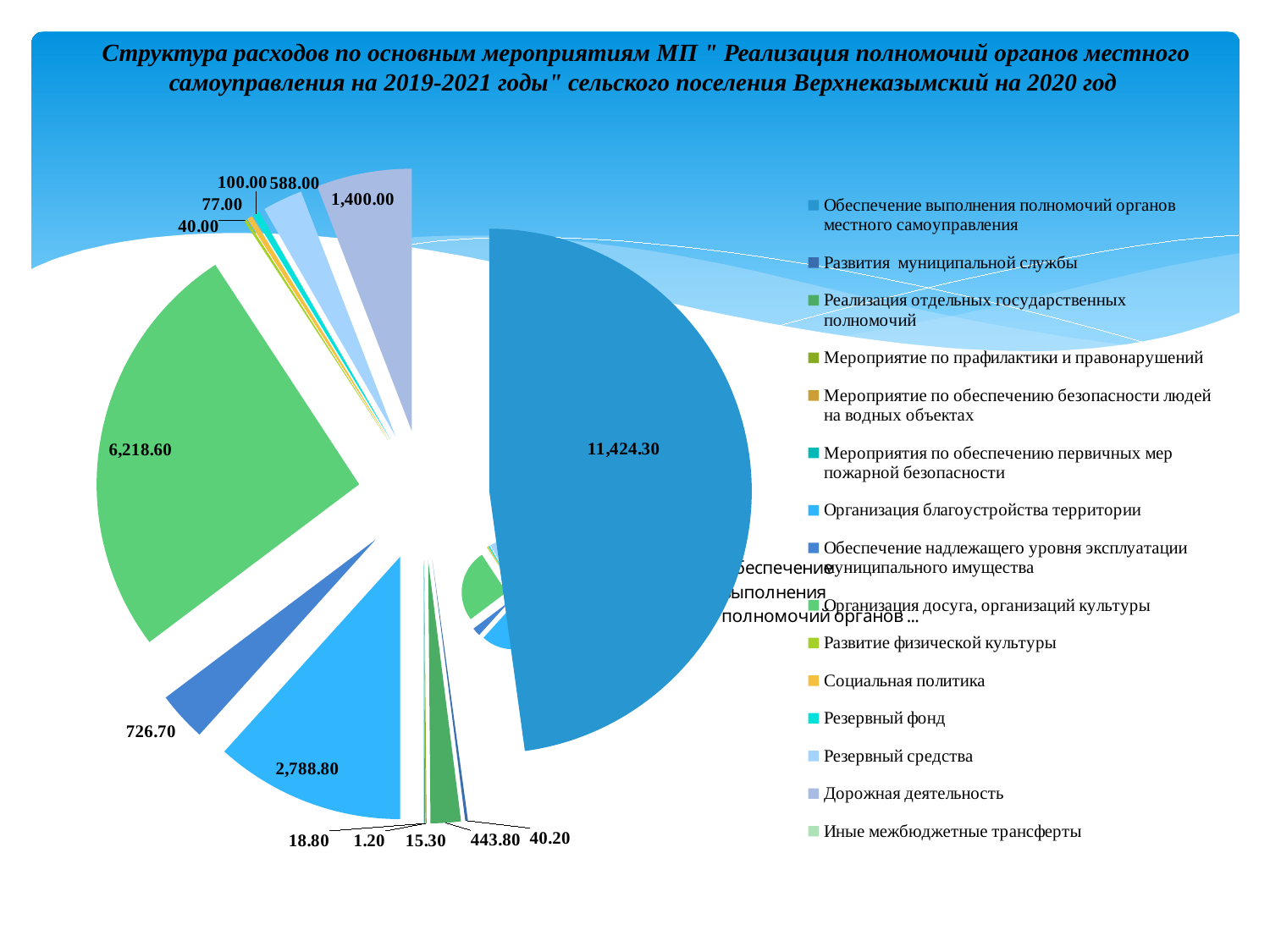
What is the last entry listed in the chart legend? Иные межбюджетные трансферты Which labelled slice is larger: the one labelled 726.70 or the one labelled 443.80? 726.70 How many entries does the legend of the pie chart list? 15 What is the difference between the slices labelled 77.00 and 40.00? 37.00 What is the smallest value labelled on the pie chart? 1.20 What kind of chart is shown on the slide? pie chart What is the largest value labelled on the pie chart? 11,424.30 What is the value of the slice for 'Обеспечение выполнения полномочий органов местного самоуправления' (the largest blue slice)? 11,424.30 Which year does the chart title say the expenditure structure is for? 2020 What is the difference between the two largest labelled slices, 11,424.30 and 6,218.60? 5,205.70 What is the difference between the slices labelled 588.00 and 100.00? 488.00 Which labelled slice is larger: the one labelled 2,788.80 or the one labelled 1,400.00? 2,788.80